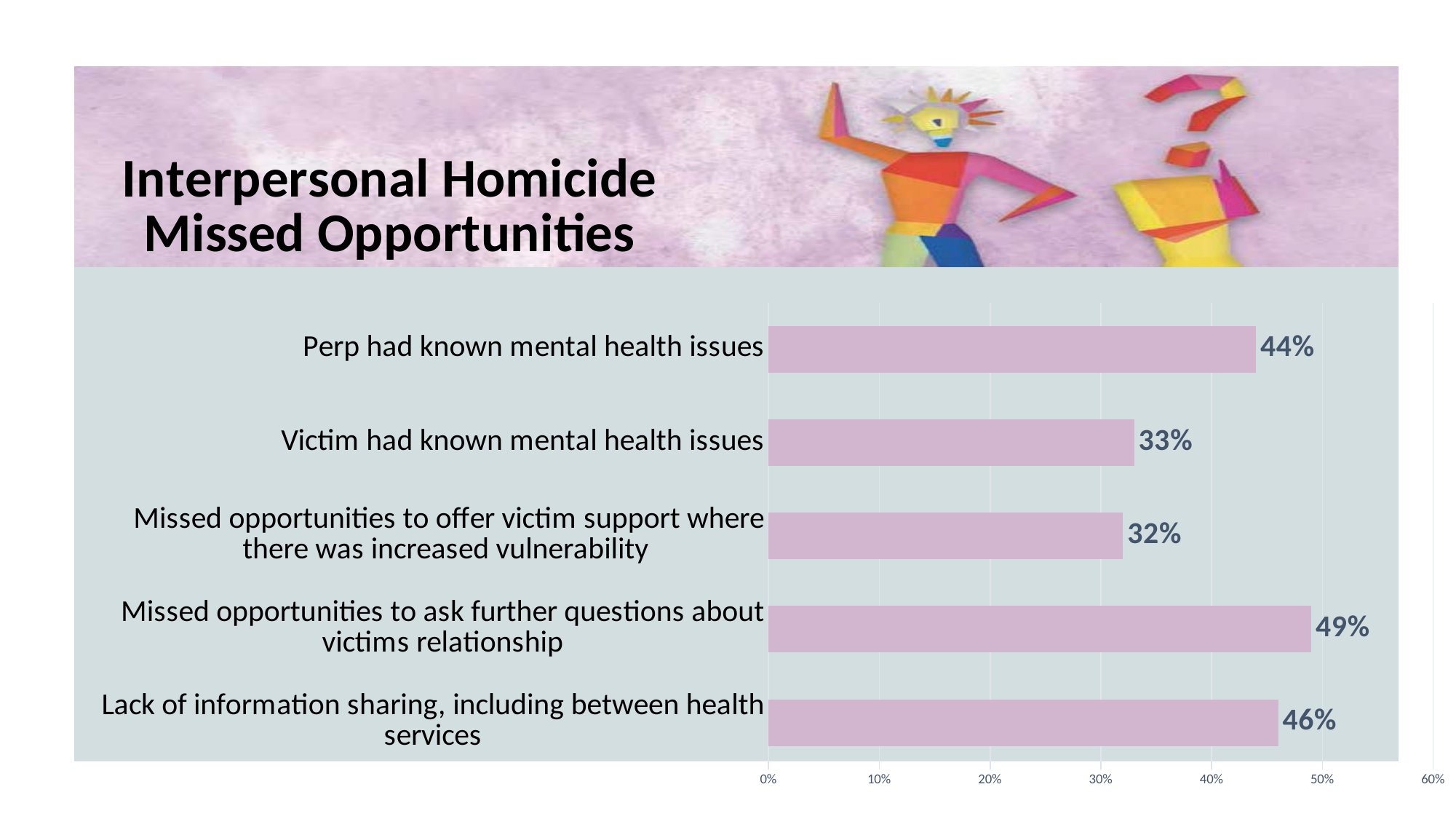
What is the title of the slide? Interpersonal Homicide Missed Opportunities What is the value for 'Victim had known mental health issues'? 33% Is the value for 'Victim had known mental health issues' greater or less than 40%? less What is the value for 'Perp had known mental health issues'? 44% What is the value for 'Lack of information sharing, including between health services'? 46% What is the value for 'Missed opportunities to offer victim support where there was increased vulnerability'? 32% What kind of chart is shown on the slide? Bar chart How many categories are shown in the chart? 5 Which category has the lowest value? Missed opportunities to offer victim support where there was increased vulnerability Which category has the highest value? Missed opportunities to ask further questions about victims relationship Which is larger: the value for 'Lack of information sharing, including between health services' or 'Perp had known mental health issues'? Lack of information sharing, including between health services What is the difference between the values for 'Missed opportunities to ask further questions about victims relationship' and 'Perp had known mental health issues'? 5%